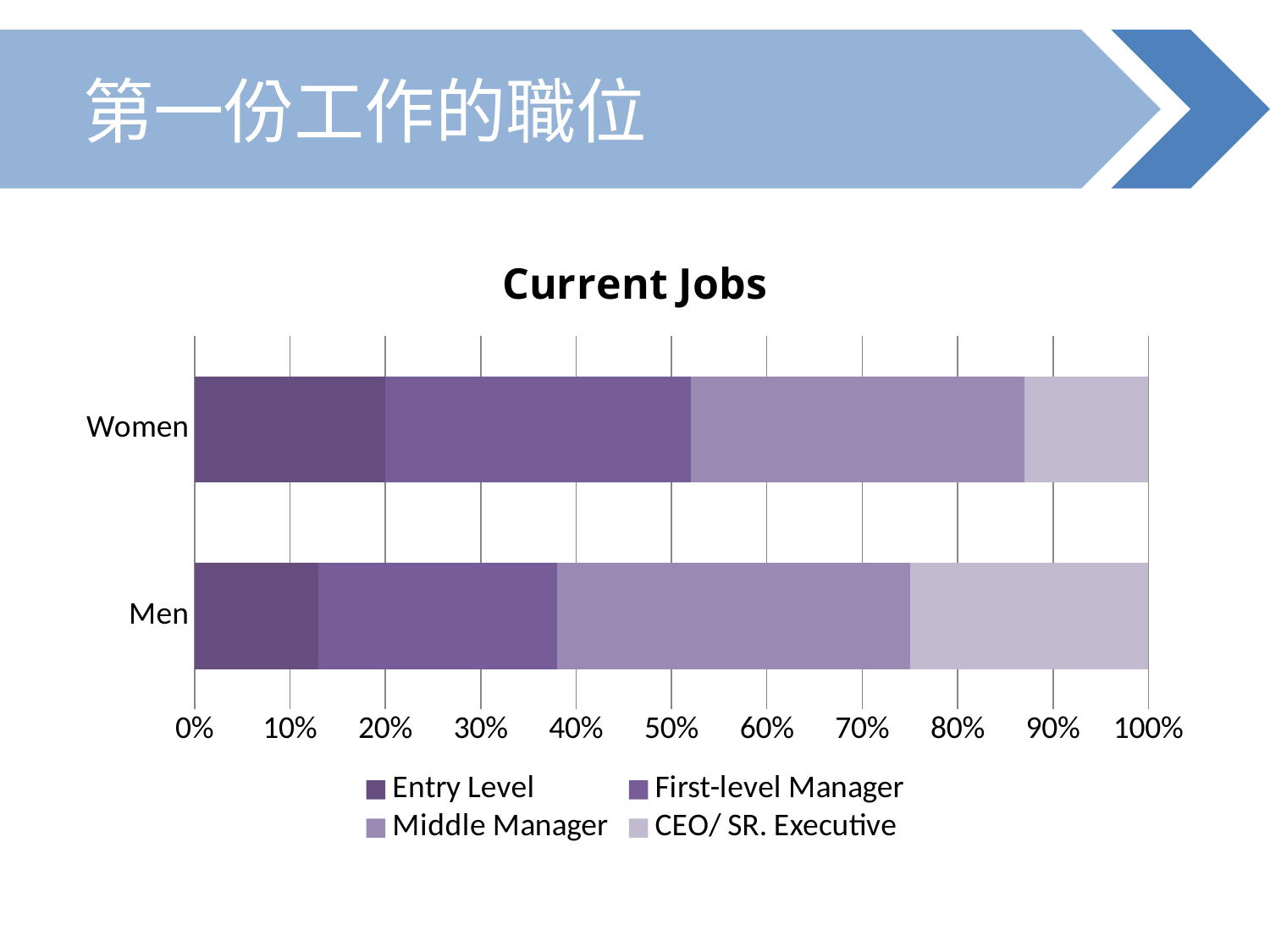
Is the CEO/ SR. Executive share for Women greater or less than 20%? less Which group has the larger Entry Level share, Women or Men? Women What is the total of the stacked bar for Women? 100% Which series is listed last in the legend? CEO/ SR. Executive What kind of chart is shown on the slide? Stacked bar chart Is the CEO/ SR. Executive share for Men greater or less than 20%? greater Is the Entry Level share for Men greater or less than 20%? less How many series does the legend list? 4 Which group has the larger CEO/ SR. Executive share, Women or Men? Men How many categories are shown on the vertical axis? 2 What is the title of the chart? Current Jobs